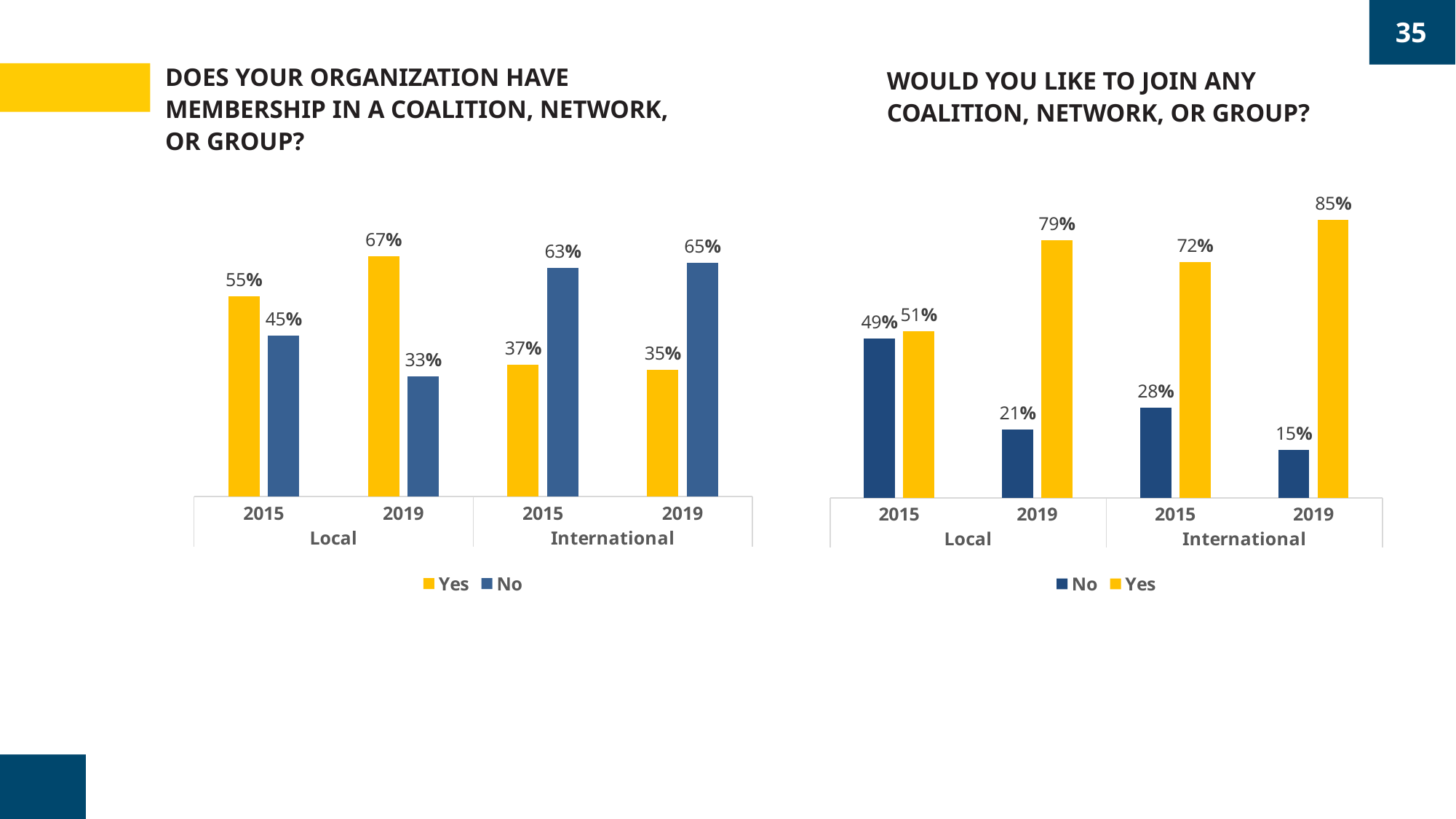
In the right chart (Would you like to join any coalition, network, or group?), what is the Yes value for International in 2019? 85% In the left chart (Does your organization have membership in a coalition, network, or group?), what is the Yes value for Local in 2019? 67% In the right chart (Would you like to join any coalition, network, or group?), which bar has the lowest value? No, International 2019 (15%) In the right chart (Would you like to join any coalition, network, or group?), what is the No value for Local in 2019? 21% How many series does the legend of the left chart list? 2 In the left chart (Does your organization have membership in a coalition, network, or group?), what is the difference between the Yes values for Local in 2019 and 2015? 12% In the left chart (Does your organization have membership in a coalition, network, or group?), which bar has the highest value? Yes, Local 2019 (67%) In the right chart (Would you like to join any coalition, network, or group?), does the Yes value rise or fall from 2015 to 2019 for Local? Rise What kind of chart is the right chart (Would you like to join any coalition, network, or group?)? Bar chart In the left chart (Does your organization have membership in a coalition, network, or group?), what is the No value for International in 2015? 63% In the right chart (Would you like to join any coalition, network, or group?), what is the difference between the Yes and No values for International in 2015? 44% In the left chart (Does your organization have membership in a coalition, network, or group?), which is larger for International in 2019: Yes or No? No